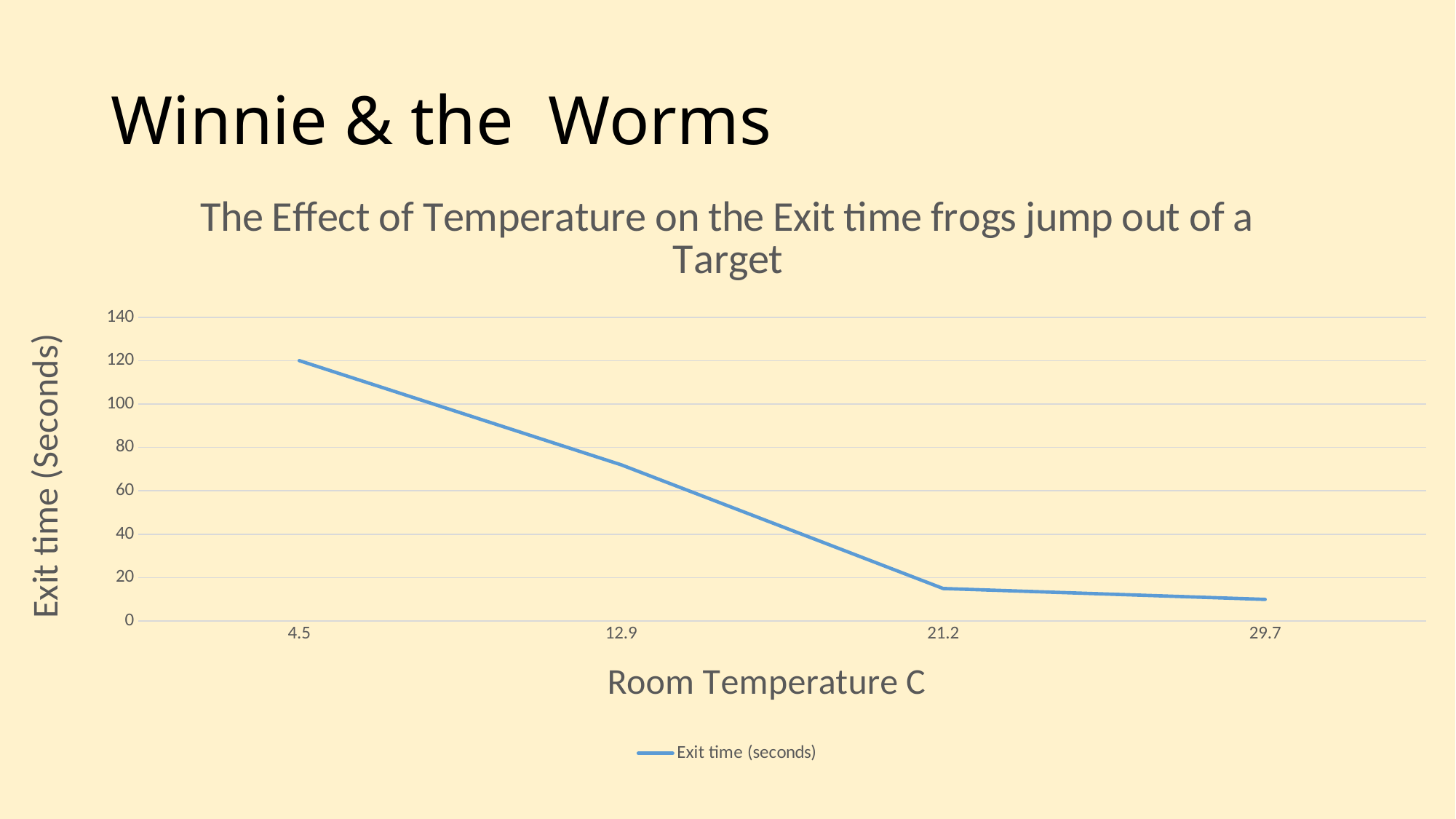
Is the exit time at 29.7 greater or less than 20? less What is the exit time at a room temperature of 4.5? 120 What kind of chart is shown on the slide? line chart At which room temperature is the exit time highest? 4.5 At which room temperature is the exit time lowest? 29.7 Does the exit time rise or fall as room temperature increases along the x axis? fall Is the exit time at 12.9 greater or less than 60? greater Is the exit time at 21.2 greater or less than 20? less What is the title of the chart? The Effect of Temperature on the Exit time frogs jump out of a Target How many temperature points are plotted on the chart? 4 Which has a larger exit time, 12.9 or 21.2? 12.9 How many series does the legend list? 1